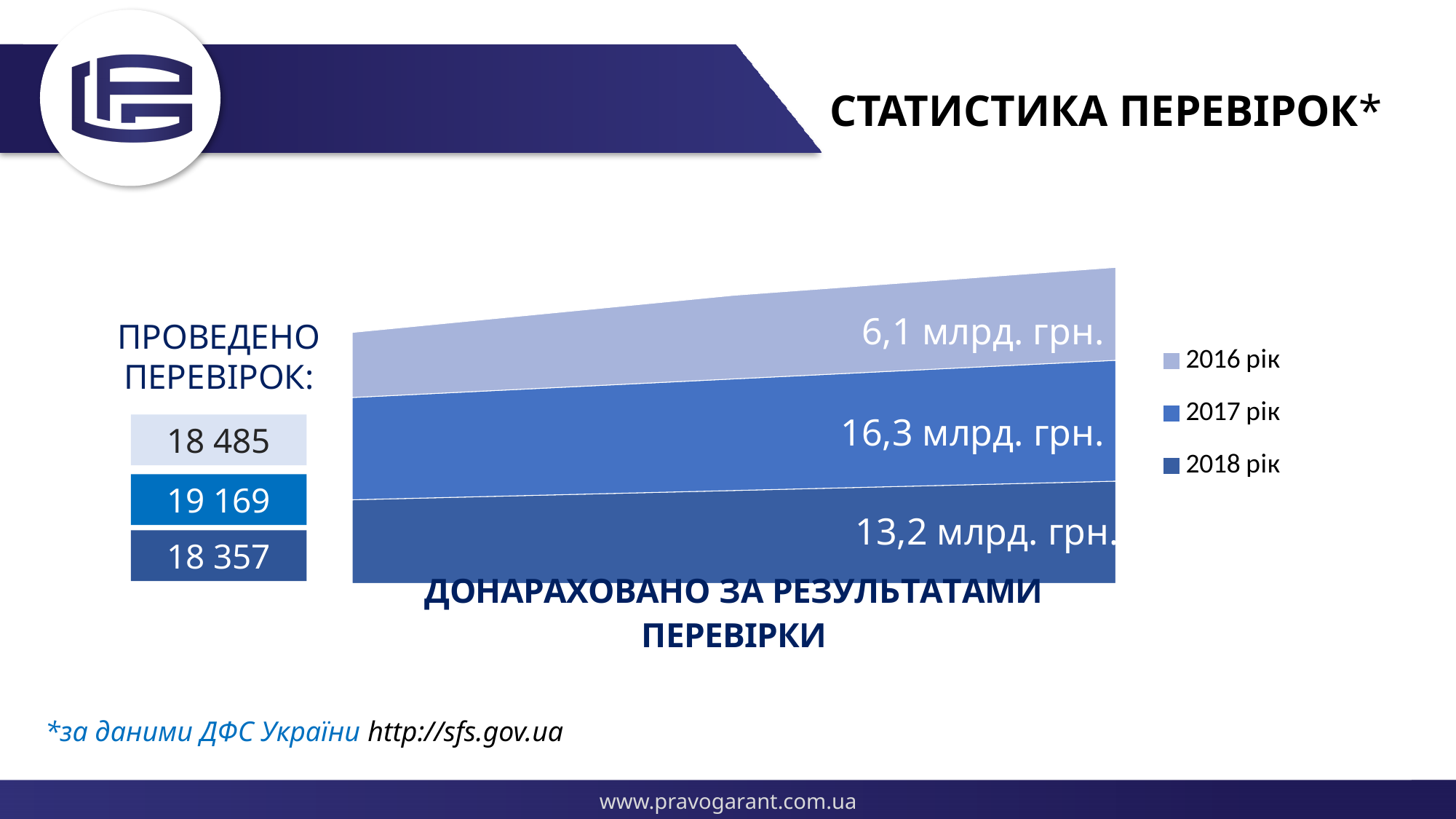
What is the difference between the values for 2017 рік and 2018 рік? 3,1 млрд. грн. Which is larger, the value for 2018 рік or the value for 2016 рік? 2018 рік Which year has the lowest value in the chart? 2016 рік What is the value shown for 2017 рік in the chart? 16,3 млрд. грн. What is the difference between the values for 2017 рік and 2016 рік? 10,2 млрд. грн. What is the title of the chart? ДОНАРАХОВАНО ЗА РЕЗУЛЬТАТАМИ ПЕРЕВІРКИ What is the value shown for 2018 рік in the chart? 13,2 млрд. грн. What is the total of the three values shown in the chart? 35,6 млрд. грн. Which legend entry is shown in the lightest shade of blue? 2016 рік Which year has the highest value in the chart? 2017 рік How many series does the chart legend list? 3 What is the value shown for 2016 рік in the chart? 6,1 млрд. грн.